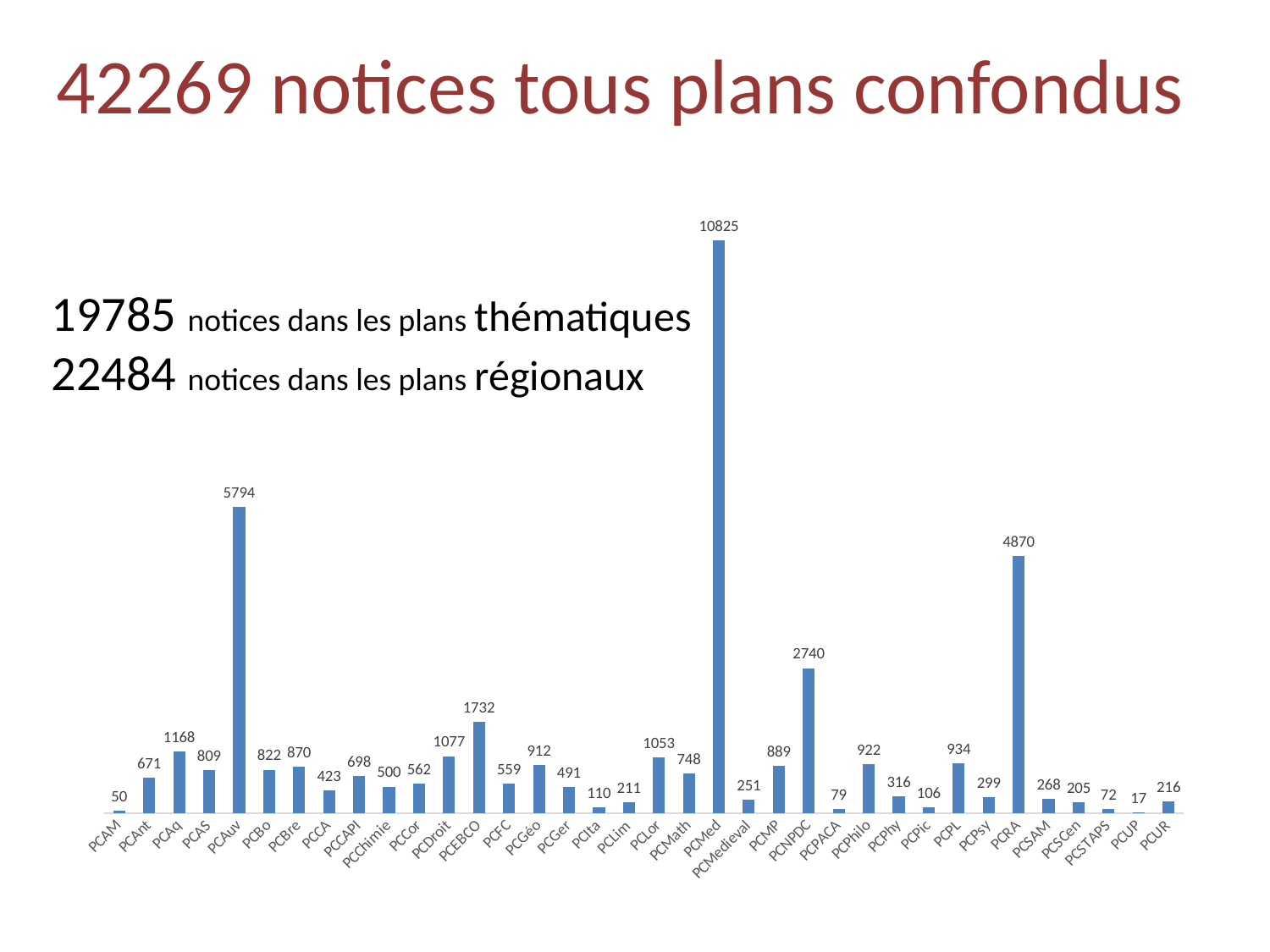
What is the value for PCEBCO? 1732 What is the difference between the values for PCRA and PCNPDC? 2130 What is the difference between the values for PCMed and PCAuv? 5031 Which is larger, the value for PCAuv or the value for PCRA? PCAuv What is the value for PCNPDC? 2740 What kind of chart is shown on the slide? Bar chart What is the value for PCMed? 10825 Which is larger, the value for PCDroit or the value for PCLor? PCDroit How many categories are shown on the x axis? 36 What is the value for PCAuv? 5794 Which category has the highest value? PCMed Which category has the lowest value? PCUP